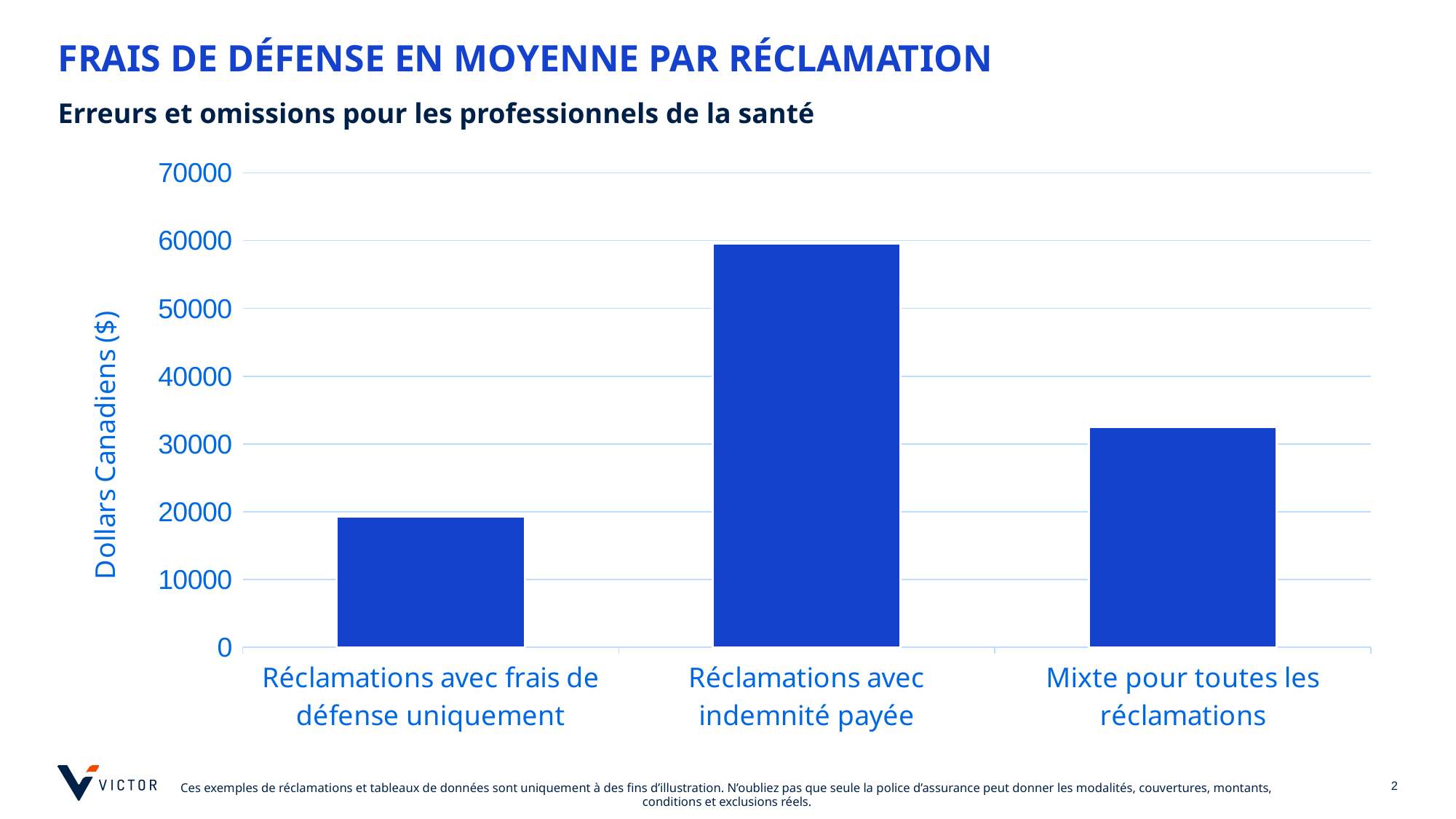
Is the value for 'Réclamations avec frais de défense uniquement' greater or less than 20000? less What is the label of the vertical axis? Dollars Canadiens ($) What is the title of the slide containing the chart? FRAIS DE DÉFENSE EN MOYENNE PAR RÉCLAMATION What kind of chart is shown on the slide? bar chart Which category has the highest average defence cost? Réclamations avec indemnité payée Is the value for 'Mixte pour toutes les réclamations' greater or less than 40000? less Which is larger: the value for 'Mixte pour toutes les réclamations' or for 'Réclamations avec frais de défense uniquement'? Mixte pour toutes les réclamations Is the value for 'Mixte pour toutes les réclamations' greater or less than 30000? greater Which is larger: the value for 'Réclamations avec indemnité payée' or for 'Mixte pour toutes les réclamations'? Réclamations avec indemnité payée Which category has the lowest average defence cost? Réclamations avec frais de défense uniquement How many categories are plotted in the chart? 3